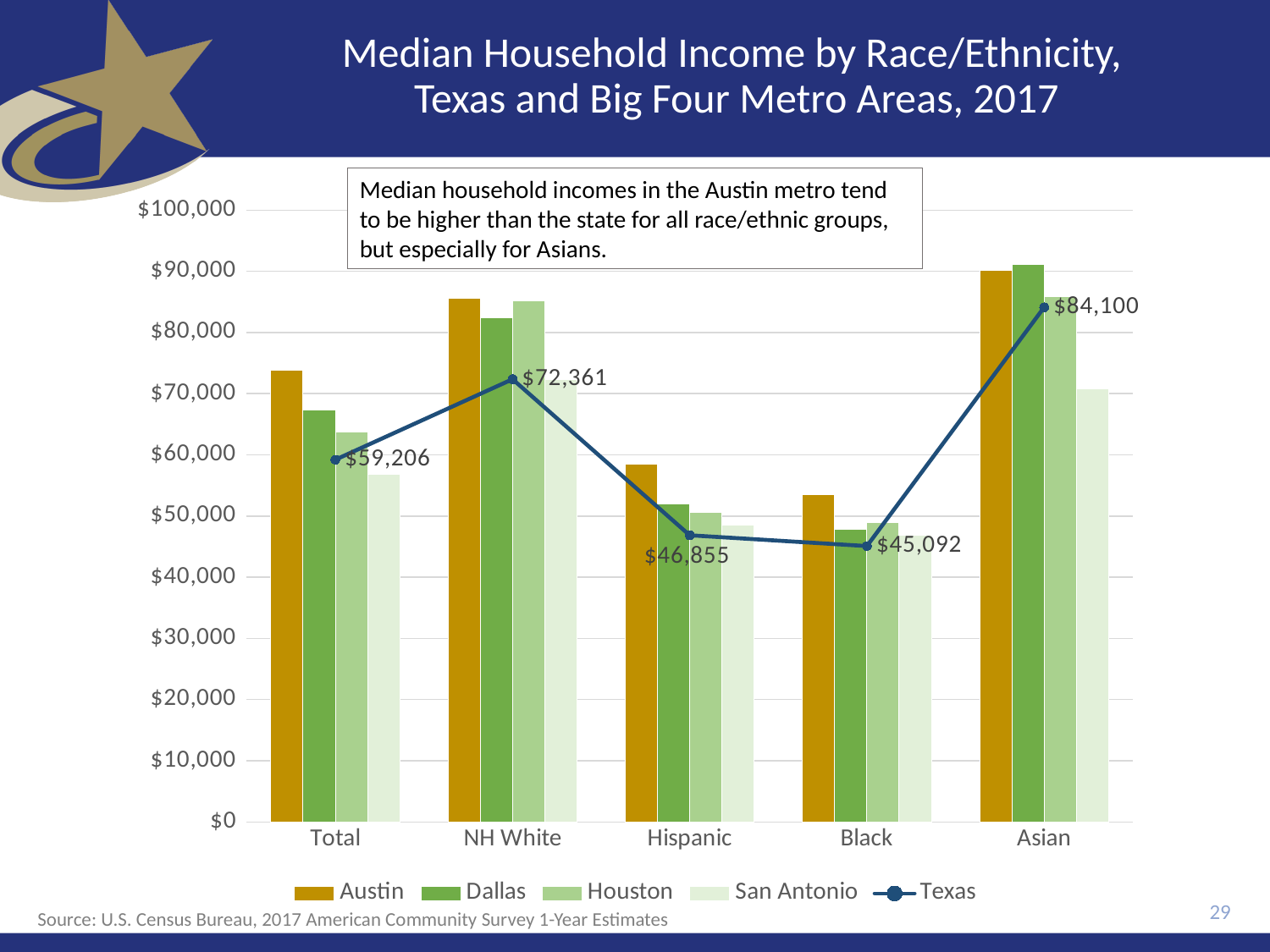
Is the Austin median household income for the Total category greater or less than $70,000? greater What is the Texas median household income for the Total category? $59,206 What is the difference between the Texas median household income for NH White and for Black households? $27,269 Is the San Antonio median household income for the Total category greater or less than $60,000? less Which race/ethnicity group has the highest Texas median household income? Asian Which race/ethnicity group has the lowest Texas median household income? Black What is the Texas median household income for Hispanic households? $46,855 What kind of chart is shown on the slide? Combined bar and line chart How many race/ethnicity categories are shown on the x axis? 5 How many series does the legend list? 5 For Asian households, which metro area has the higher median household income, Austin or San Antonio? Austin What is the Texas median household income for Asian households? $84,100